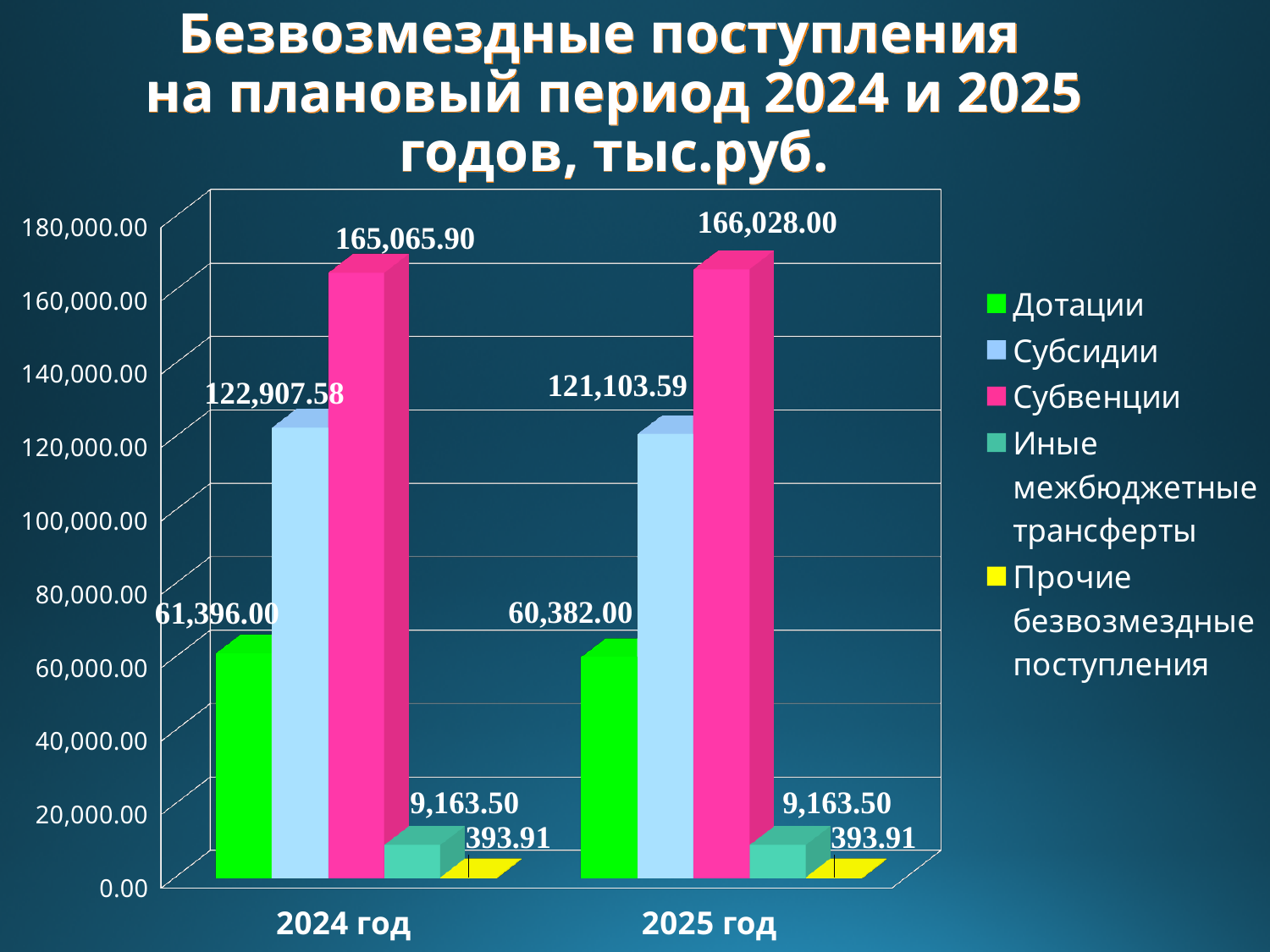
What is the value for Субсидии in 2024 год? 122,907.58 What is the value for Субвенции in 2024 год? 165,065.90 How many categories are shown on the x axis? 2 What is the difference between Субвенции in 2025 год and Субвенции in 2024 год? 962.10 What is the value for Иные межбюджетные трансферты in 2025 год? 9,163.50 What is the value for Дотации in 2025 год? 60,382.00 What colour represents Субвенции in the legend? Pink Which series has the lowest value in 2024 год? Прочие безвозмездные поступления Which is larger: Дотации in 2024 год or Дотации in 2025 год? Дотации in 2024 год What kind of chart is shown on the slide? Bar chart Which series has the highest value in 2025 год? Субвенции How many series does the legend list? 5